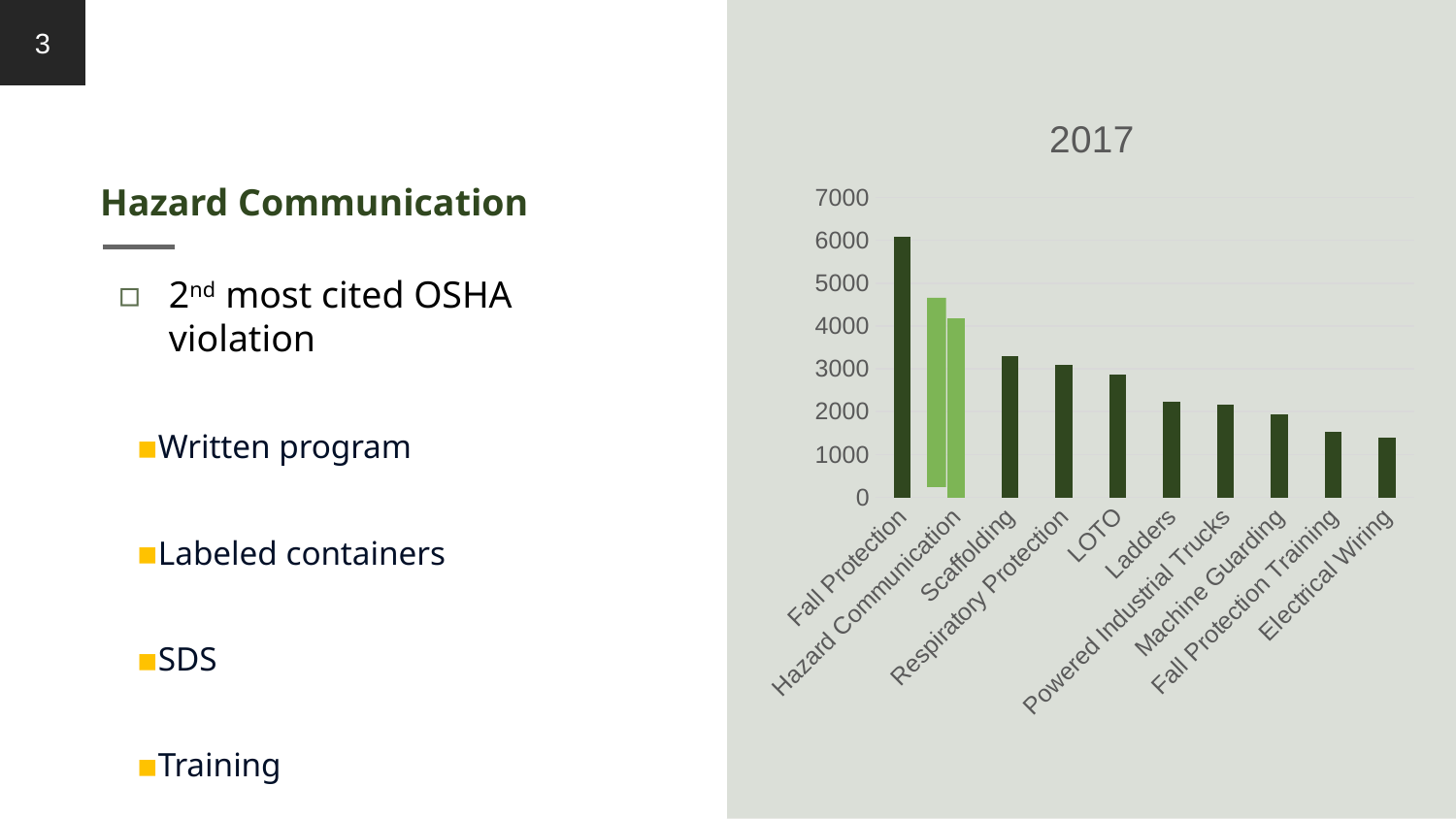
Which is larger, the value for Fall Protection or the value for Scaffolding? Fall Protection What kind of chart is shown on the slide? bar chart Is the value for Electrical Wiring greater or less than 2000? less What is the title of the chart? 2017 Is the value for Fall Protection greater or less than 5000? greater Is the value for Scaffolding greater or less than 4000? less How many categories are shown on the x axis of the chart? 10 Which category has the highest value in the chart? Fall Protection Do the values generally rise or fall moving from left to right along the x axis? fall Which category's bars are shown in a lighter green than the others? Hazard Communication